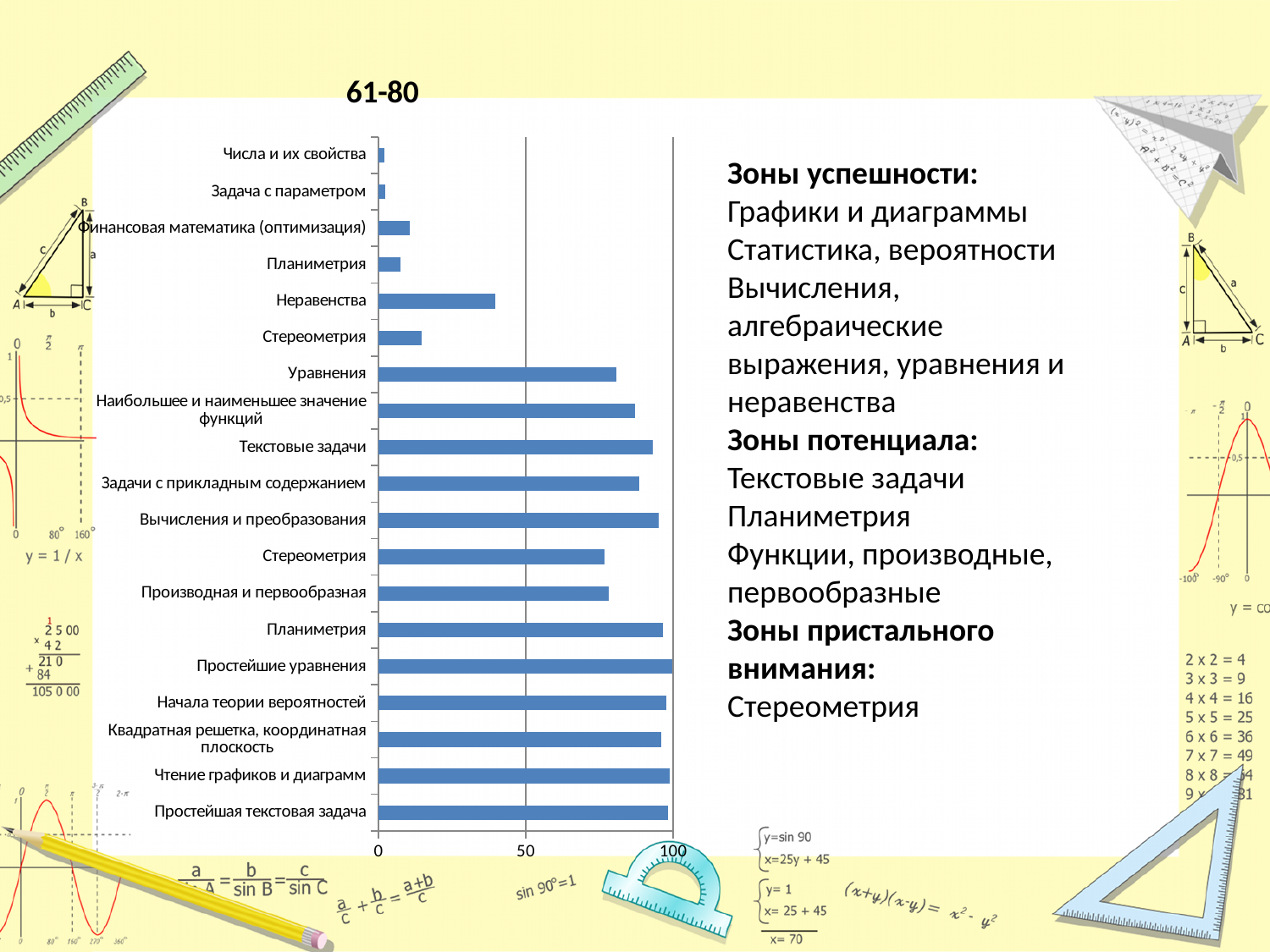
What colour are the bars in the chart? blue Is the value for Текстовые задачи greater or less than 50? greater Is the value for Финансовая математика (оптимизация) greater or less than 50? less Which is larger, the value for Задача с параметром or the value for Производная и первообразная? Производная и первообразная What kind of chart is shown on the slide? bar chart Is the value for Уравнения greater or less than 50? greater Which category has the highest value in the chart? Простейшие уравнения What is the title of the chart? 61-80 How many categories are plotted in the chart? 19 Which is larger, the value for Неравенства or the value for Уравнения? Уравнения Which is larger, the value for Неравенства or the value for Финансовая математика (оптимизация)? Неравенства